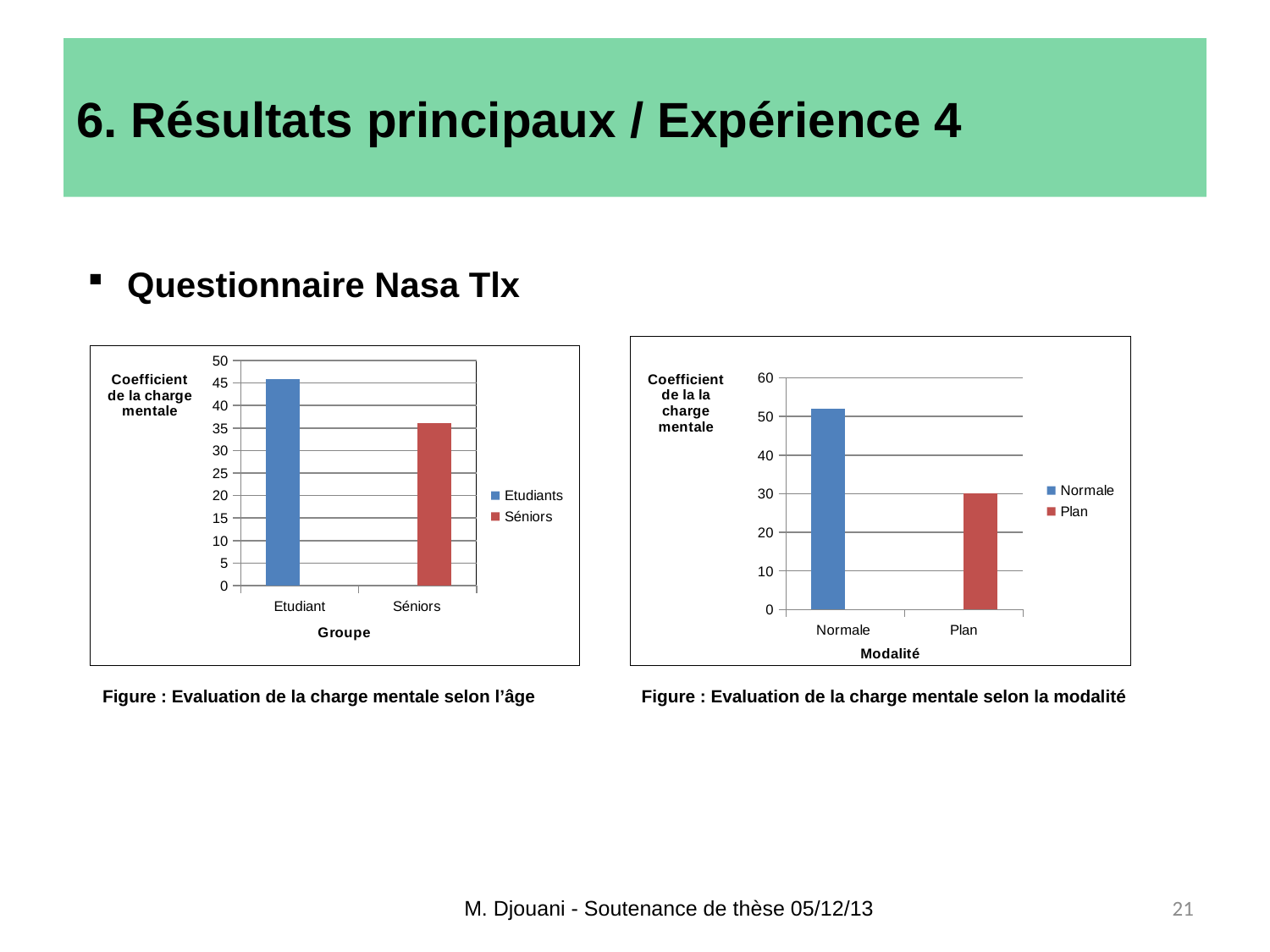
In the right chart (Evaluation de la charge mentale selon la modalité), which modalité has the higher coefficient de la charge mentale? Normale In the right chart (Evaluation de la charge mentale selon la modalité), how many categories are shown on the x axis? 2 In the left chart (Evaluation de la charge mentale selon l'âge), is the value for Séniors greater or less than 40? less In the right chart (Evaluation de la charge mentale selon la modalité), what is the title of the x axis? Modalité In the left chart (Evaluation de la charge mentale selon l'âge), which group has the higher coefficient de la charge mentale? Etudiant In the left chart (Evaluation de la charge mentale selon l'âge), is the value for Etudiant greater or less than 40? greater In the right chart (Evaluation de la charge mentale selon la modalité), is the value for Plan greater or less than 40? less In the left chart (Evaluation de la charge mentale selon l'âge), what is the title of the x axis? Groupe In the left chart (Evaluation de la charge mentale selon l'âge), which group has the lower coefficient de la charge mentale? Séniors In the left chart (Evaluation de la charge mentale selon l'âge), what kind of chart is shown? bar chart In the left chart (Evaluation de la charge mentale selon l'âge), how many series does the legend list? 2